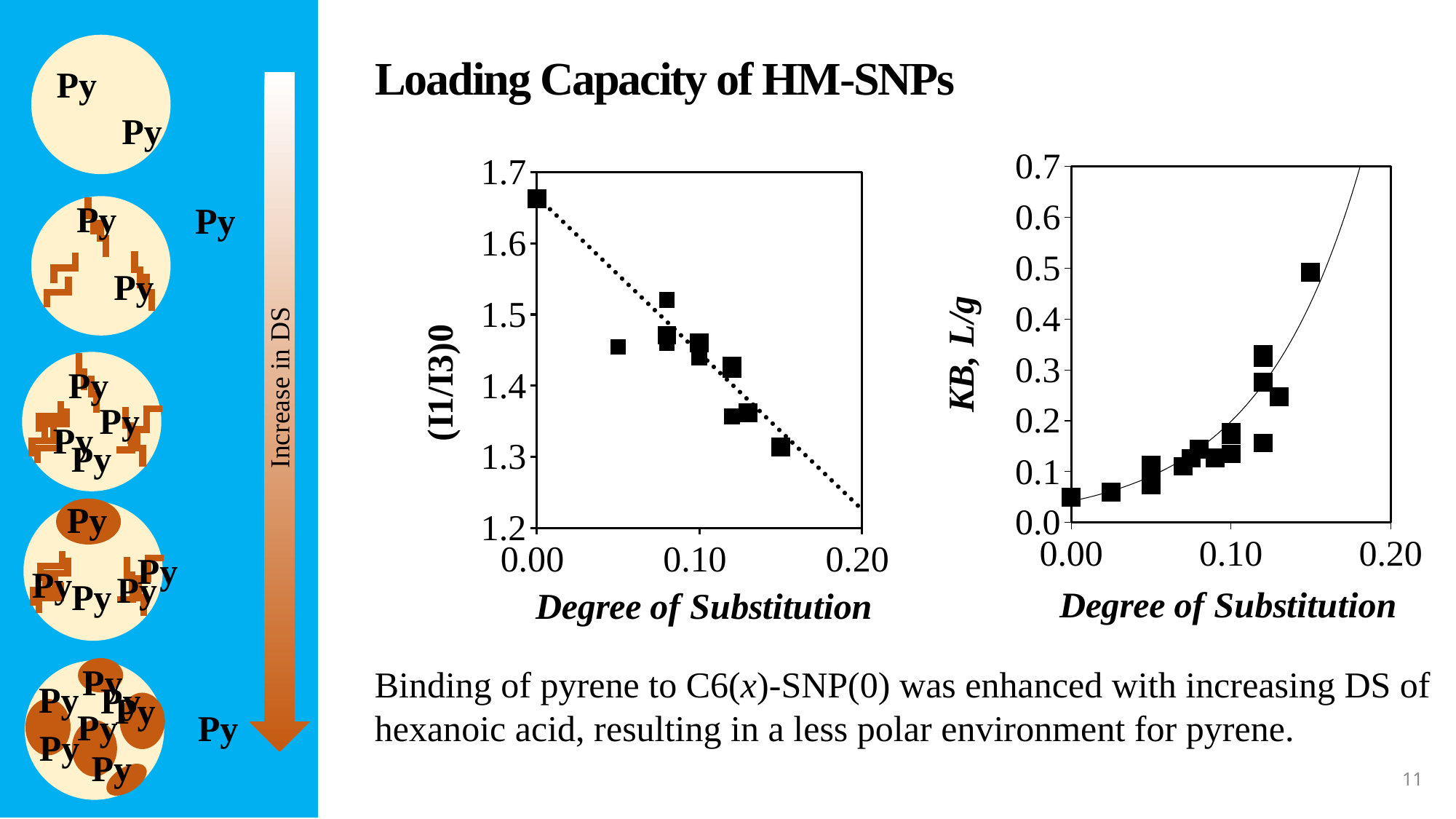
In the right chart, is the KB value at Degree of Substitution 0.00 greater or less than 0.1? less What kind of chart is the left chart with y-axis (I1/I3)0? scatter chart In the left chart, is the (I1/I3)0 value of the point near Degree of Substitution 0.15 greater or less than 1.4? less What is the y-axis label of the right chart? KB, L/g What kind of chart is the right chart with y-axis KB, L/g? scatter chart In the right chart, which point has the highest KB value: the one near Degree of Substitution 0.15 or the one at 0.00? the one near 0.15 In the right chart, is the KB value of the point near Degree of Substitution 0.15 greater or less than 0.4? greater In the left chart, which point has the higher (I1/I3)0 value: the one at Degree of Substitution 0.00 or the one near 0.15? the one at 0.00 In the right chart, do the KB values rise or fall as Degree of Substitution increases? rise What is the x-axis label of the right chart? Degree of Substitution In the left chart, do the (I1/I3)0 values rise or fall as Degree of Substitution increases? fall